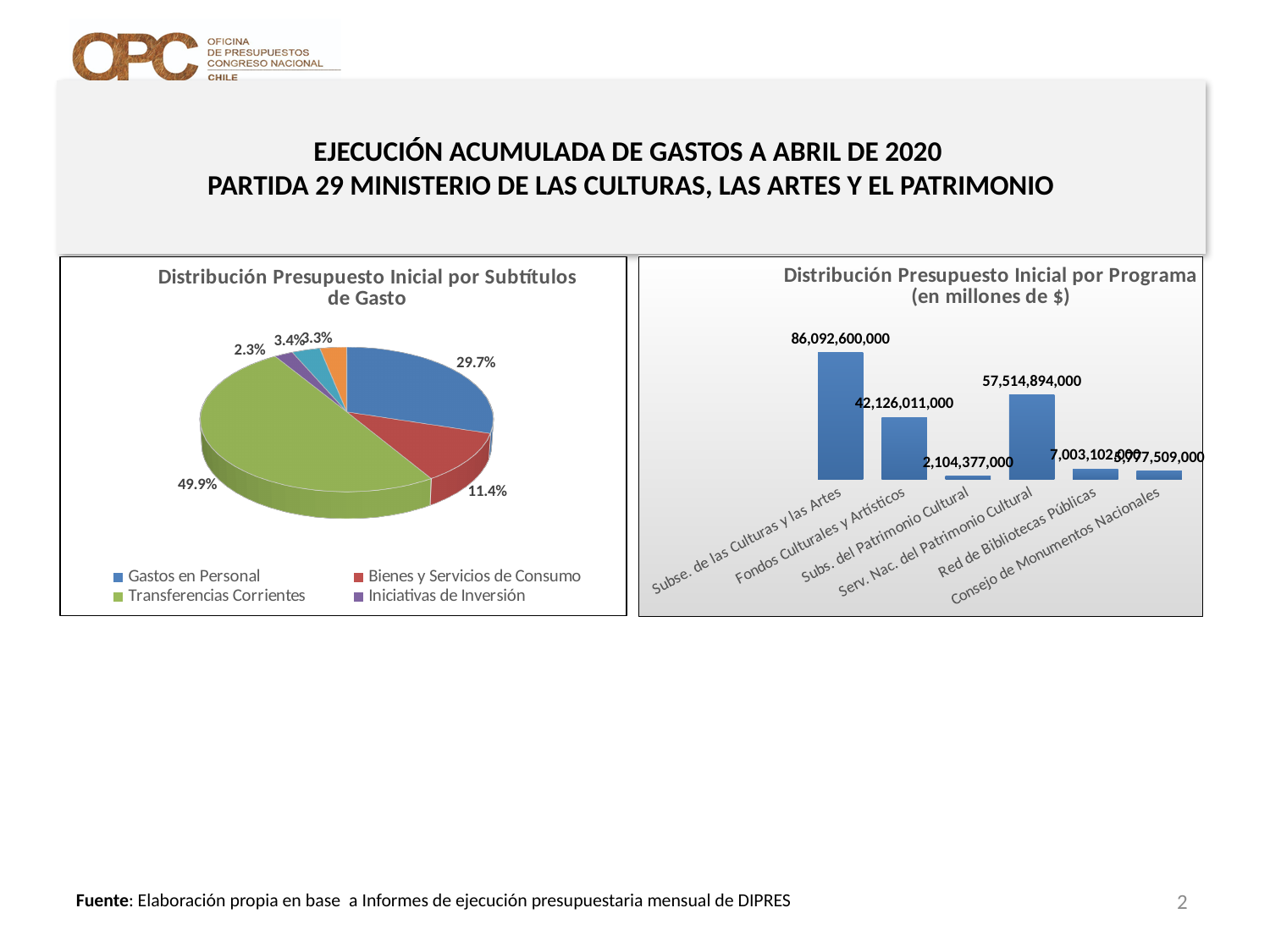
In the pie chart 'Distribución Presupuesto Inicial por Subtítulos de Gasto', how many entries does the legend list? 4 In the chart 'Distribución Presupuesto Inicial por Programa', how many programs are shown? 6 In the pie chart 'Distribución Presupuesto Inicial por Subtítulos de Gasto', which category has the largest slice? Transferencias Corrientes In the chart 'Distribución Presupuesto Inicial por Programa', what is the value for Subse. de las Culturas y las Artes? 86,092,600,000 In the pie chart 'Distribución Presupuesto Inicial por Subtítulos de Gasto', what share does Gastos en Personal have? 29.7% In the chart 'Distribución Presupuesto Inicial por Programa', what is the value for Subs. del Patrimonio Cultural? 2,104,377,000 In the chart 'Distribución Presupuesto Inicial por Programa', what is the value for Serv. Nac. del Patrimonio Cultural? 57,514,894,000 In the pie chart 'Distribución Presupuesto Inicial por Subtítulos de Gasto', what share does Bienes y Servicios de Consumo have? 11.4% What kind of chart is 'Distribución Presupuesto Inicial por Programa'? Bar chart In the pie chart 'Distribución Presupuesto Inicial por Subtítulos de Gasto', what is the difference in percentage points between Gastos en Personal and Bienes y Servicios de Consumo? 18.3 percentage points In the pie chart 'Distribución Presupuesto Inicial por Subtítulos de Gasto', what share does Transferencias Corrientes have? 49.9% In the chart 'Distribución Presupuesto Inicial por Programa', which program has the lowest value? Subs. del Patrimonio Cultural